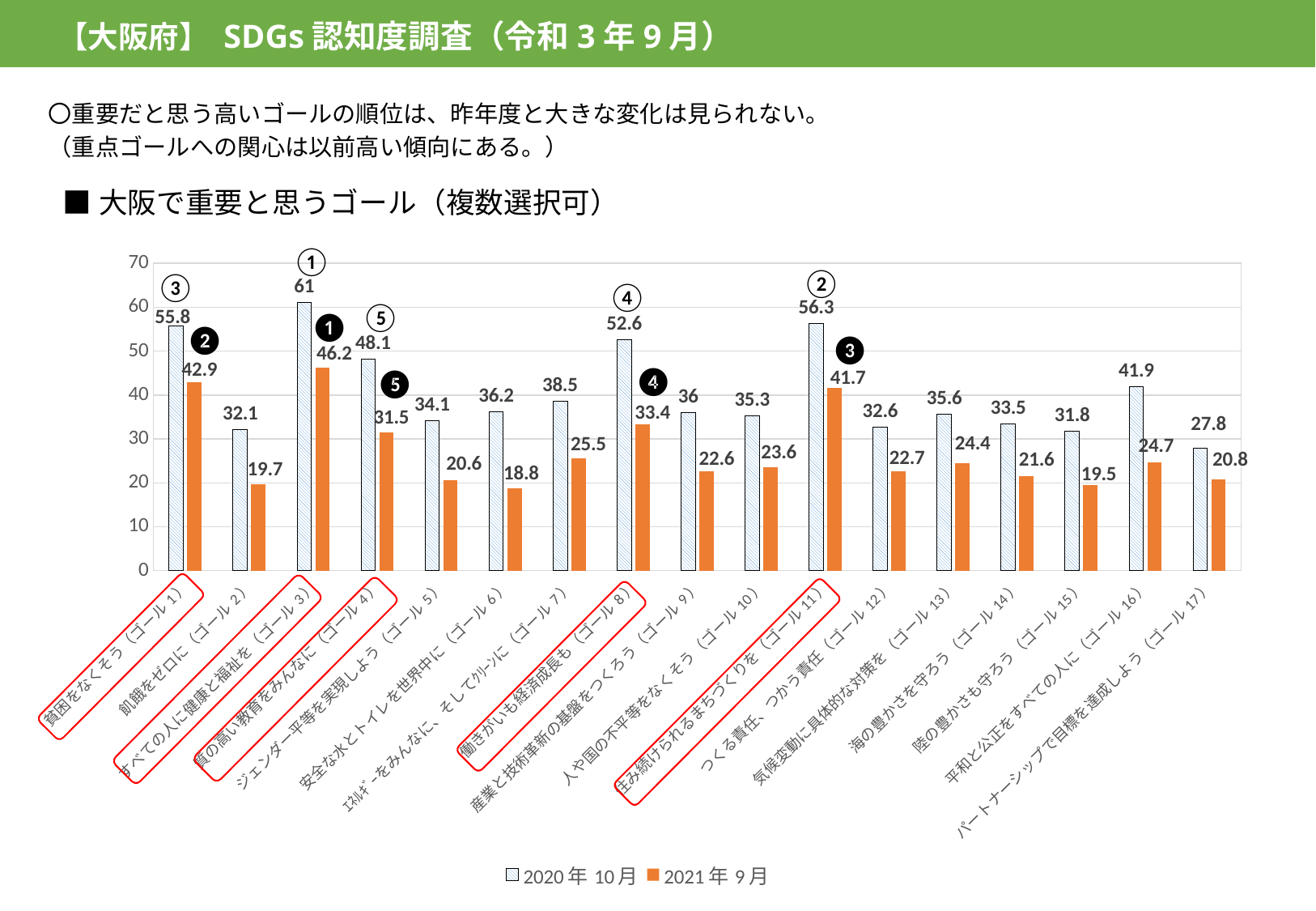
What kind of chart is shown on the slide? Bar chart What is the 2021年9月 value for 住み続けられるまちづくりを（ゴール11）? 41.7 Which goal has the lowest 2020年10月 value? パートナーシップで目標を達成しよう（ゴール17） Which goal has the highest 2020年10月 value? すべての人に健康と福祉を（ゴール3） Which goal has the lowest 2021年9月 value? 安全な水とトイレを世界中に（ゴール6） How many series does the legend list? 2 What is the 2020年10月 value for すべての人に健康と福祉を（ゴール3）? 61 How many goals (categories) are shown on the x axis? 17 What is the difference between the 2020年10月 and 2021年9月 values for 貧困をなくそう（ゴール1）? 12.9 Which series is shown in orange in the legend? 2021年9月 Which is larger for 2021年9月: 働きがいも経済成長も（ゴール8） or 平和と公正をすべての人に（ゴール16）? 働きがいも経済成長も（ゴール8）